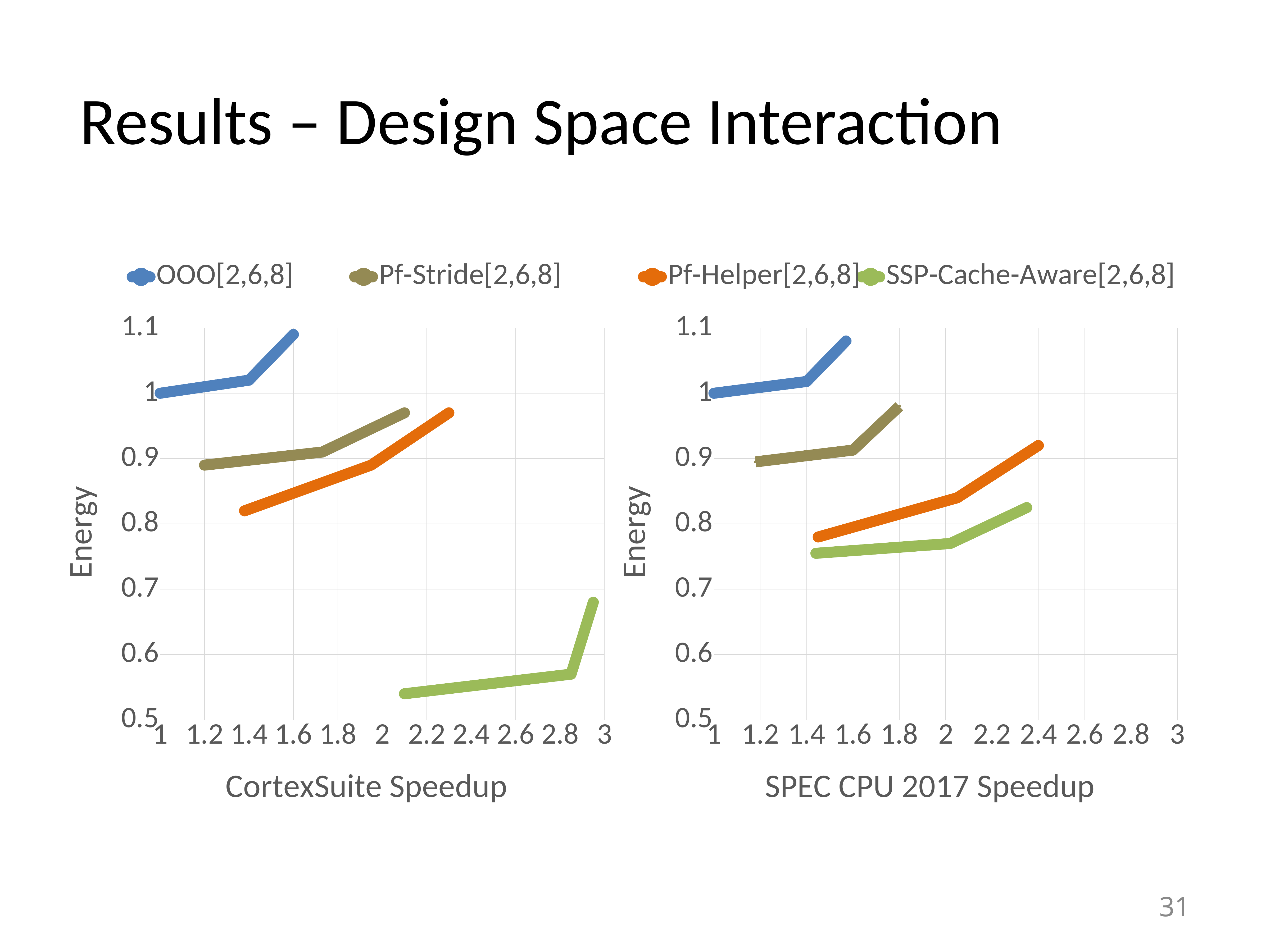
In the CortexSuite Speedup chart, how many points does the OOO[2,6,8] line have? 3 In the CortexSuite Speedup chart, which series has the lowest energy values? SSP-Cache-Aware[2,6,8] In the SPEC CPU 2017 Speedup chart, which series has the highest energy values? OOO[2,6,8] In the CortexSuite Speedup chart, which series reaches the highest speedup, SSP-Cache-Aware[2,6,8] or OOO[2,6,8]? SSP-Cache-Aware[2,6,8] In the SPEC CPU 2017 Speedup chart, is the energy for OOO[2,6,8] greater or less than 0.9 at every point? greater In the CortexSuite Speedup chart, is the energy for SSP-Cache-Aware[2,6,8] greater or less than 0.8 at every point? less In the CortexSuite Speedup chart, does the energy for Pf-Helper[2,6,8] rise or fall as speedup increases? rise What is the x-axis title of the right chart? SPEC CPU 2017 Speedup In the SPEC CPU 2017 Speedup chart, is the energy for SSP-Cache-Aware[2,6,8] greater or less than 0.9 at every point? less What kind of chart is the left chart (CortexSuite Speedup)? line chart How many series does the legend list? 4 What is the y-axis title of the charts? Energy